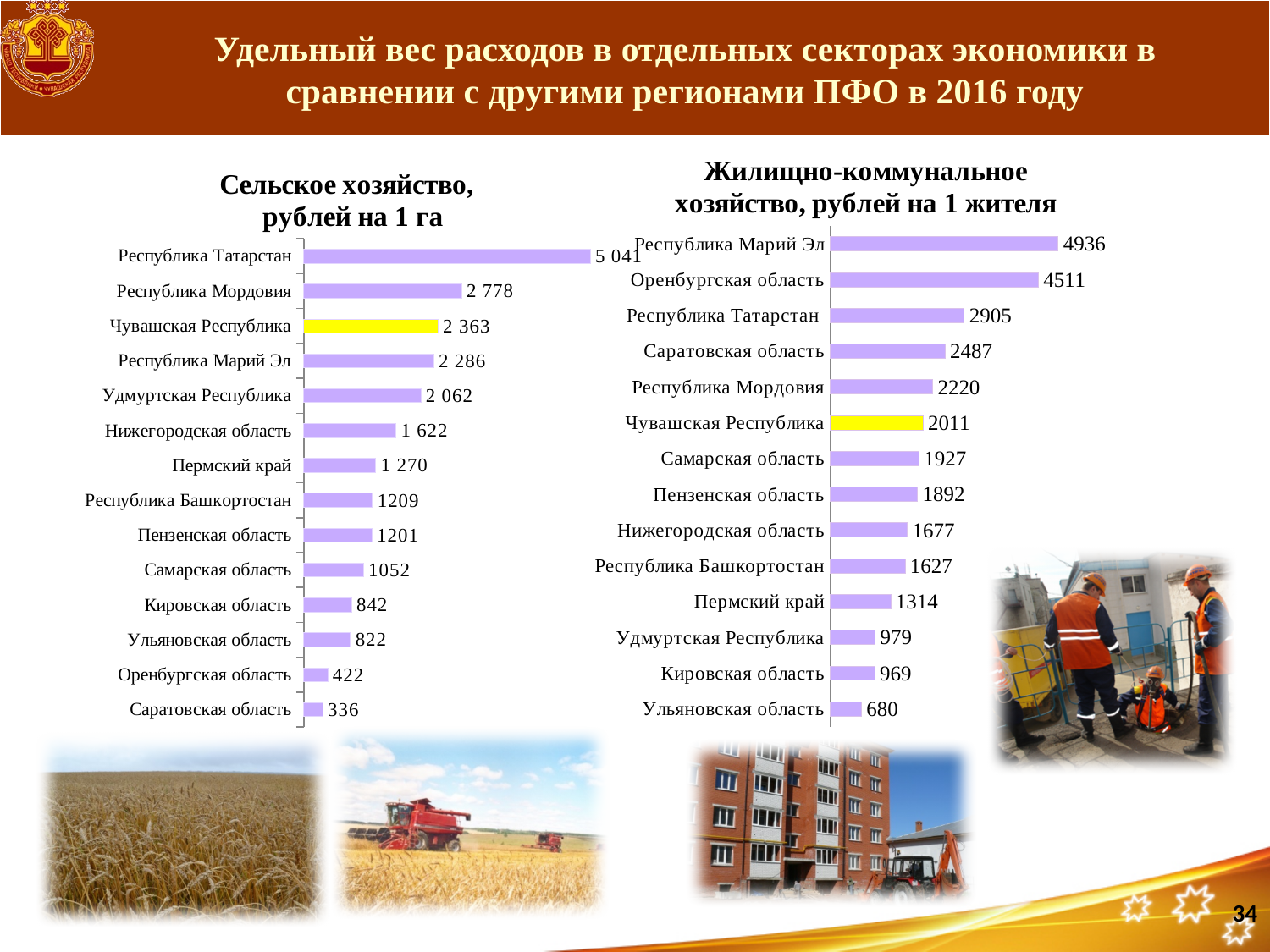
In the chart 'Жилищно-коммунальное хозяйство, рублей на 1 жителя', which region has the lowest value? Ульяновская область In the chart 'Сельское хозяйство, рублей на 1 га', what is the difference between Республика Татарстан and Республика Мордовия? 2 263 In the chart 'Сельское хозяйство, рублей на 1 га', how many regions are shown? 14 In the chart 'Сельское хозяйство, рублей на 1 га', which region has the highest value? Республика Татарстан In the chart 'Жилищно-коммунальное хозяйство, рублей на 1 жителя', which region has the highest value? Республика Марий Эл In the chart 'Жилищно-коммунальное хозяйство, рублей на 1 жителя', what is the difference between Республика Марий Эл and Чувашская Республика? 2925 In the chart 'Жилищно-коммунальное хозяйство, рублей на 1 жителя', which region's bar is highlighted in yellow? Чувашская Республика In the chart 'Жилищно-коммунальное хозяйство, рублей на 1 жителя', what is the value for Оренбургская область? 4511 In the chart 'Сельское хозяйство, рублей на 1 га', which region has the lowest value? Саратовская область In the chart 'Сельское хозяйство, рублей на 1 га', what is the value for Чувашская Республика? 2 363 What type of chart is 'Сельское хозяйство, рублей на 1 га'? Bar chart In the chart 'Жилищно-коммунальное хозяйство, рублей на 1 жителя', which is larger: Саратовская область or Республика Мордовия? Саратовская область